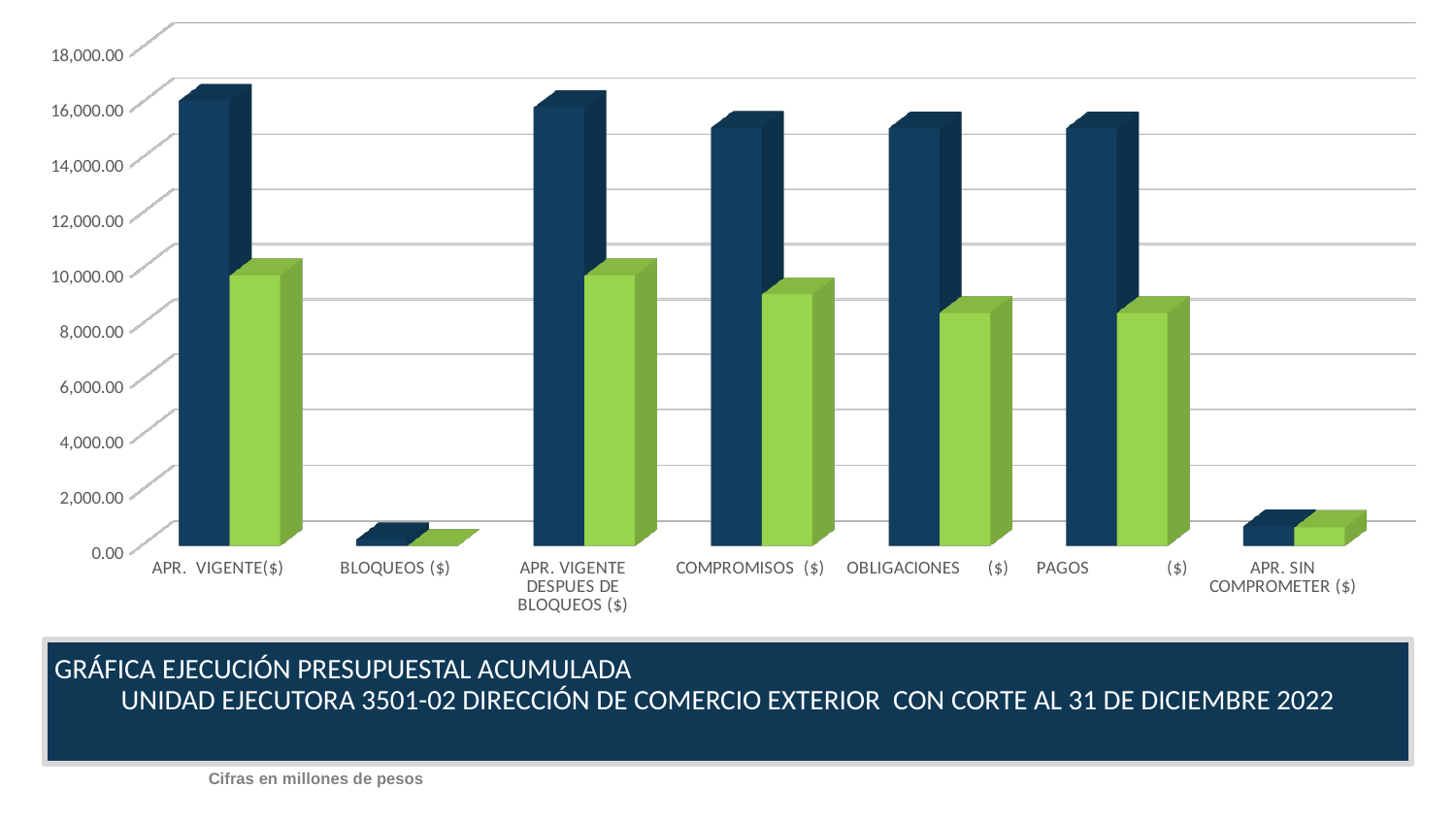
For APR. VIGENTE($), which bar is taller, the dark blue one or the green one? the dark blue one Which category has the lowest green bar? BLOQUEOS ($) According to the note below the chart, in what units are the figures expressed? millones de pesos How many categories are shown along the x axis of the chart? 7 Is the dark blue bar for BLOQUEOS ($) greater or less than 2,000.00? less Which green bar is taller, APR. VIGENTE($) or PAGOS ($)? APR. VIGENTE($) Is the green bar for PAGOS ($) greater or less than 10,000.00? less Is the green bar for COMPROMISOS ($) greater or less than 8,000.00? greater What kind of chart is shown on the slide? bar chart What is the highest value shown on the vertical axis of the chart? 18,000.00